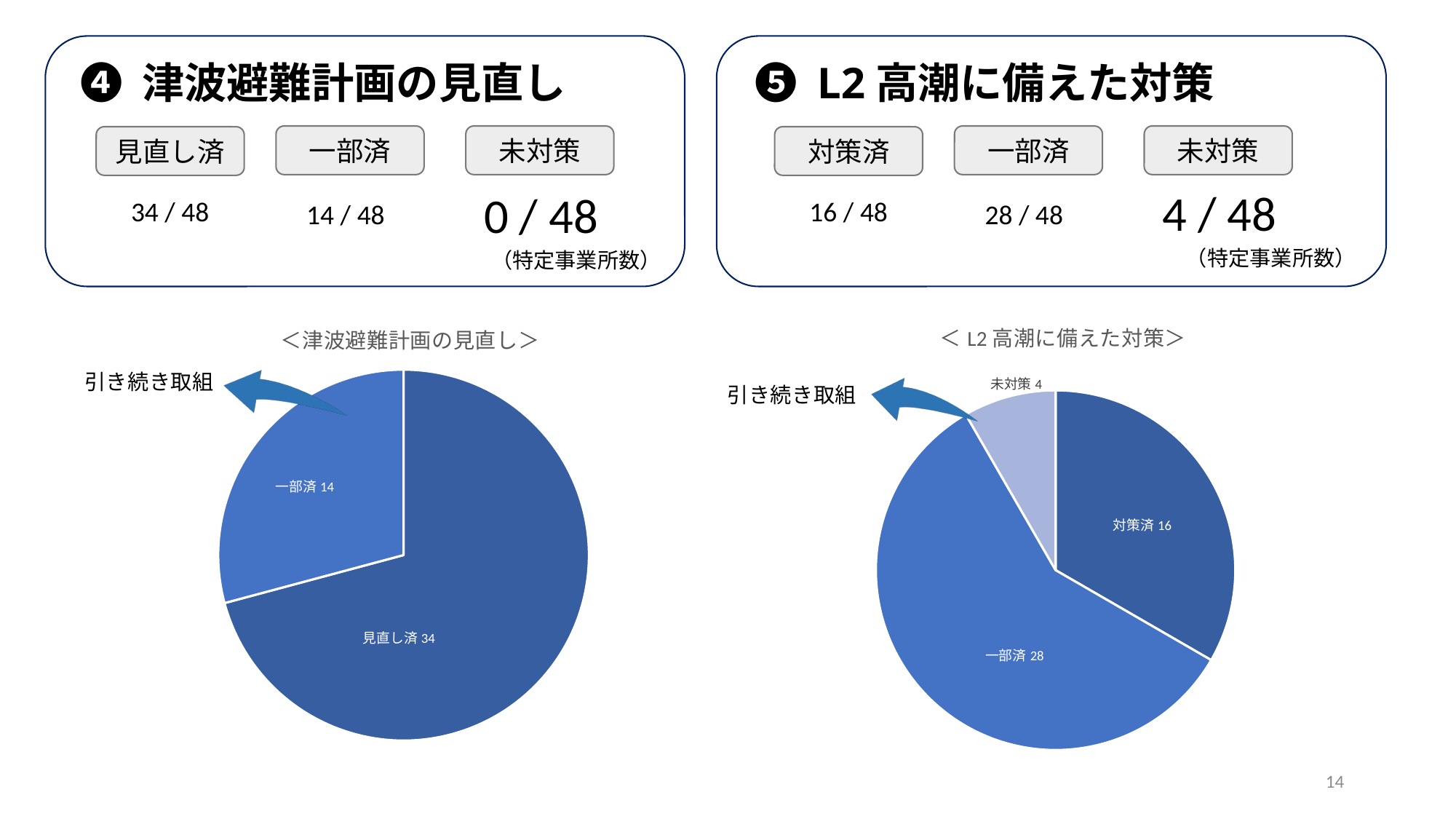
In the right pie chart (L2高潮に備えた対策), which category has the smallest slice? 未対策 In the right pie chart (L2高潮に備えた対策), which is larger, 対策済 or 一部済? 一部済 In the left pie chart (津波避難計画の見直し), which category has the largest slice? 見直し済 In the right pie chart (L2高潮に備えた対策), what is the value for 一部済? 28 What type of chart is used on the right side of the slide (L2高潮に備えた対策)? Pie chart In the left pie chart (津波避難計画の見直し), what is the difference between 見直し済 and 一部済? 20 In the left pie chart (津波避難計画の見直し), what is the value for 見直し済? 34 In the left pie chart (津波避難計画の見直し), what is the value for 一部済? 14 In the right pie chart (L2高潮に備えた対策), what is the value for 未対策? 4 In the right pie chart (L2高潮に備えた対策), how many slices are shown? 3 In the right pie chart (L2高潮に備えた対策), what is the difference between 一部済 and 対策済? 12 In the left pie chart (津波避難計画の見直し), how many slices are shown? 2